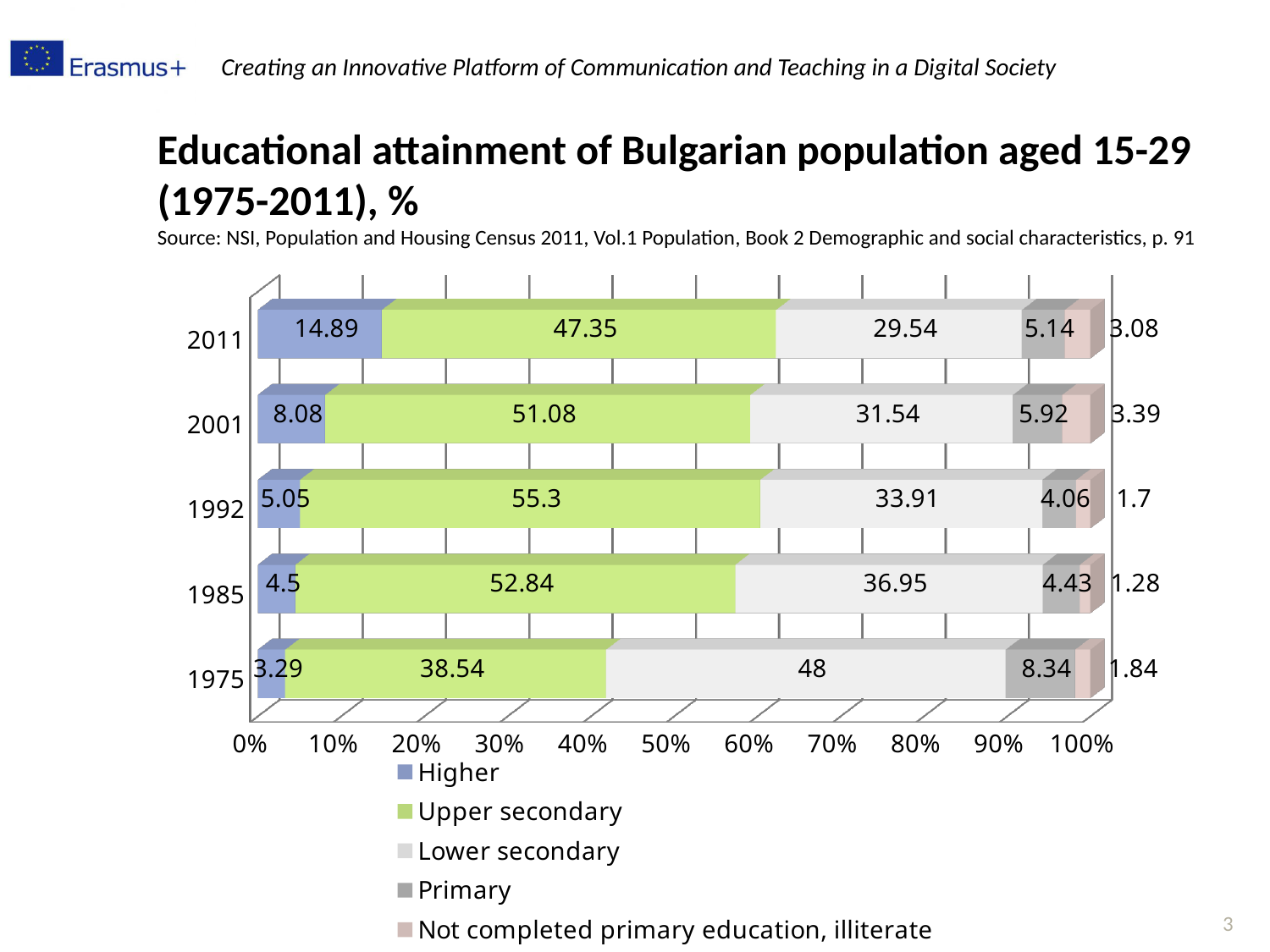
What is the difference between the Higher education values for 2011 and 2001? 6.81 Which year has the lowest value for Upper secondary education? 1975 Which is larger: the Lower secondary value for 1985 or for 1992? 1985 What is the value for Higher education in 2011? 14.89 Which legend entry is shown in green? Upper secondary What kind of chart is shown on the slide? Stacked bar chart Which year has the highest value for Higher education? 2011 What is the value for Lower secondary education in 1975? 48 What is the value for Primary education in 2001? 5.92 What is the value for Upper secondary education in 1992? 55.3 How many years are shown on the chart? 5 How many series does the legend list? 5